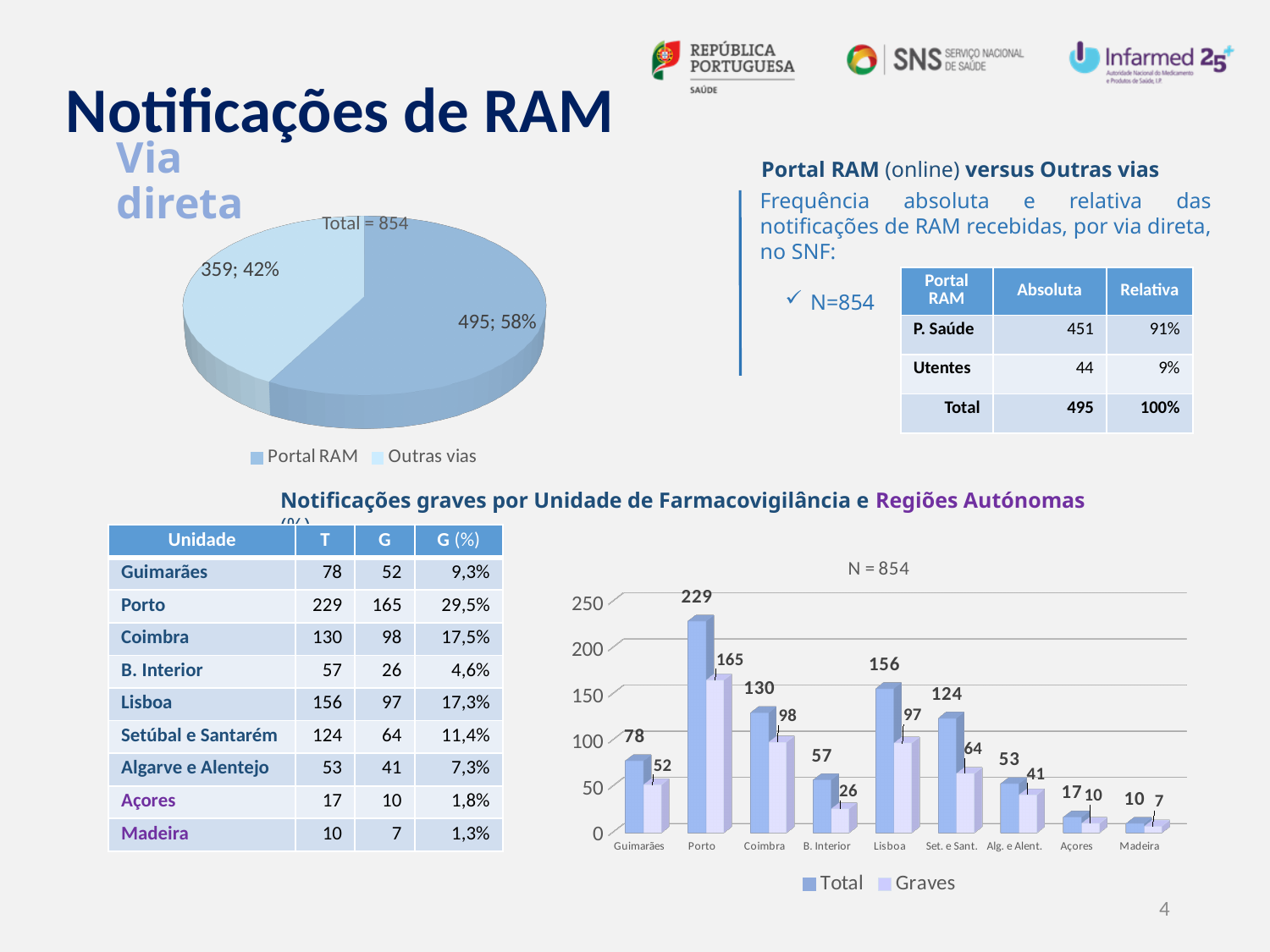
In the pie chart, how many series does the legend list? 2 In the bar chart (N = 854), which is larger: the Total value for Lisboa or the Total value for Set. e Sant.? Lisboa In the pie chart, what total is shown above the pie? Total = 854 In the bar chart (N = 854), which category has the highest Total value? Porto In the bar chart (N = 854), what is the Graves value for Lisboa? 97 In the pie chart, what value is shown for Portal RAM? 495; 58% In the bar chart (N = 854), what is the difference between the Total and Graves values for Coimbra? 32 In the bar chart (N = 854), which category has the lowest Graves value? Madeira In the bar chart (N = 854), what is the Total value for Porto? 229 In the bar chart (N = 854), how many categories are shown on the x axis? 9 What kind of chart is the chart titled N = 854? Bar chart In the pie chart, what share of the pie does Outras vias represent? 42%